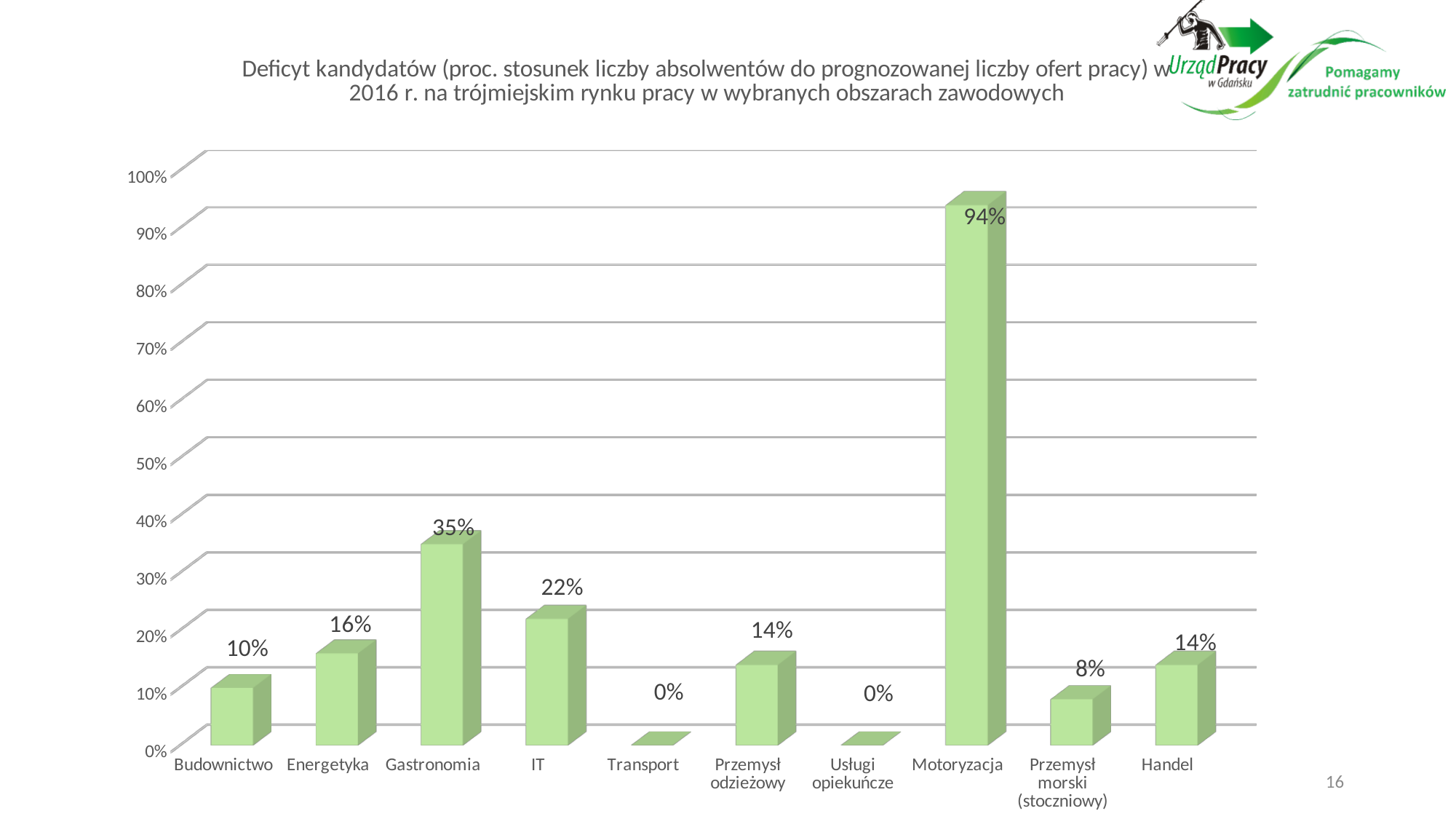
Which is larger, the value for Budownictwo or the value for Energetyka? Energetyka What is the value for IT? 22% What kind of chart is shown on the slide? bar chart Which category has the highest value? Motoryzacja What is the value for Motoryzacja? 94% What is the difference between the values for Gastronomia and Energetyka? 19% What is the value for Gastronomia? 35% How many categories are shown on the x axis? 10 Which categories have a value of 0%? Transport and Usługi opiekuńcze What is the highest value shown on the vertical axis? 100% Is the value for Motoryzacja greater or less than 90%? greater What is the value for Przemysł morski (stoczniowy)? 8%